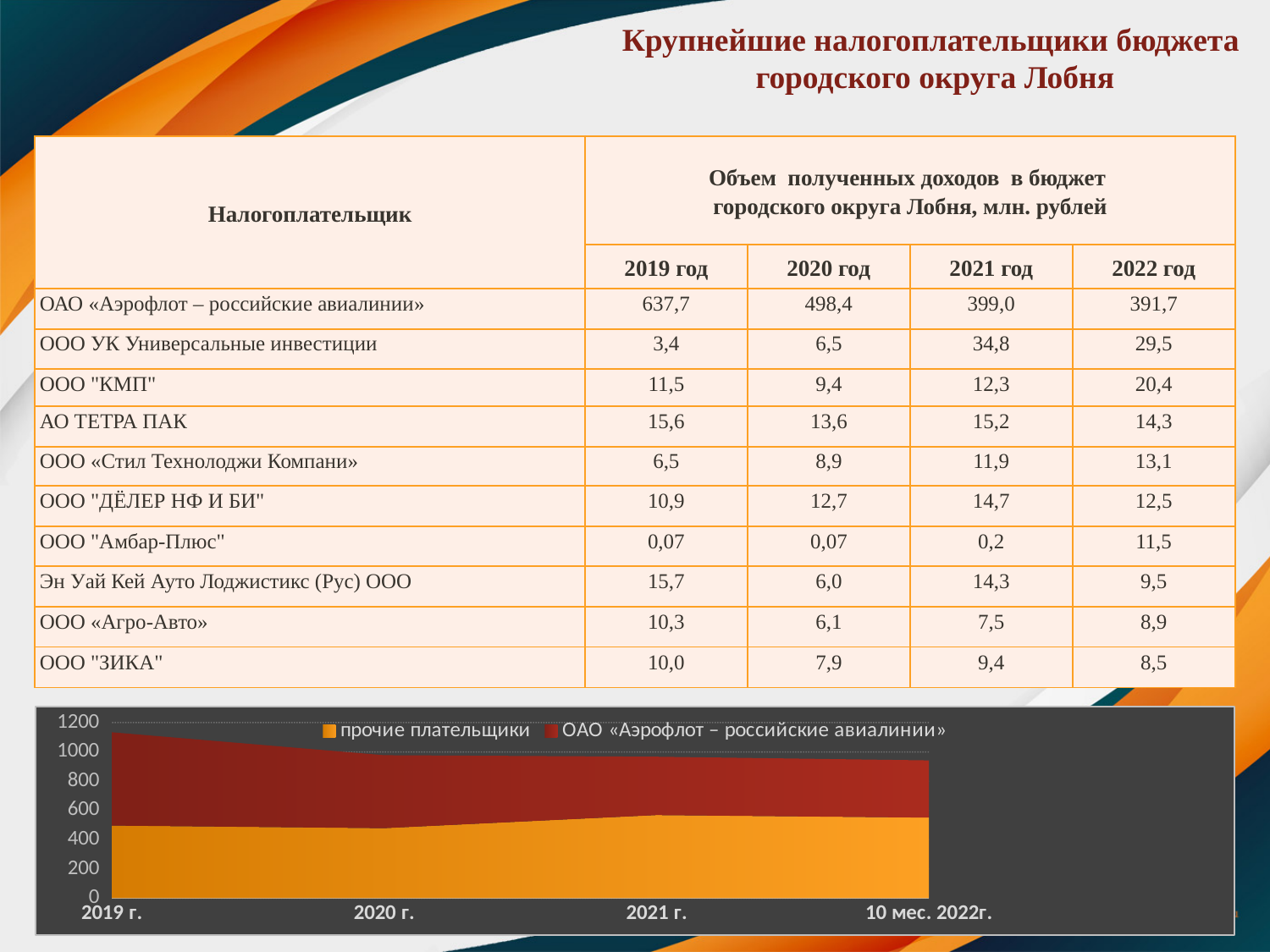
Does the total height of the stacked areas rise or fall from 2019 г. to 10 мес. 2022г.? fall Is the value for прочие плательщики in 2021 г. greater or less than 800? less Which series in the chart is drawn in dark red? ОАО «Аэрофлот – российские авиалинии» What kind of chart is shown at the bottom of the slide? area chart How many periods are shown along the x axis of the chart? 4 Is the total of the stacked areas for 10 мес. 2022г. greater or less than 1000? less What is the last period labelled on the x axis of the chart? 10 мес. 2022г. Is the total of the stacked areas for 2019 г. larger or smaller than the total for 10 мес. 2022г.? larger Is the value for прочие плательщики in 2019 г. greater or less than 400? greater What is the highest value labelled on the y axis of the chart? 1200 How many series does the legend of the chart list? 2